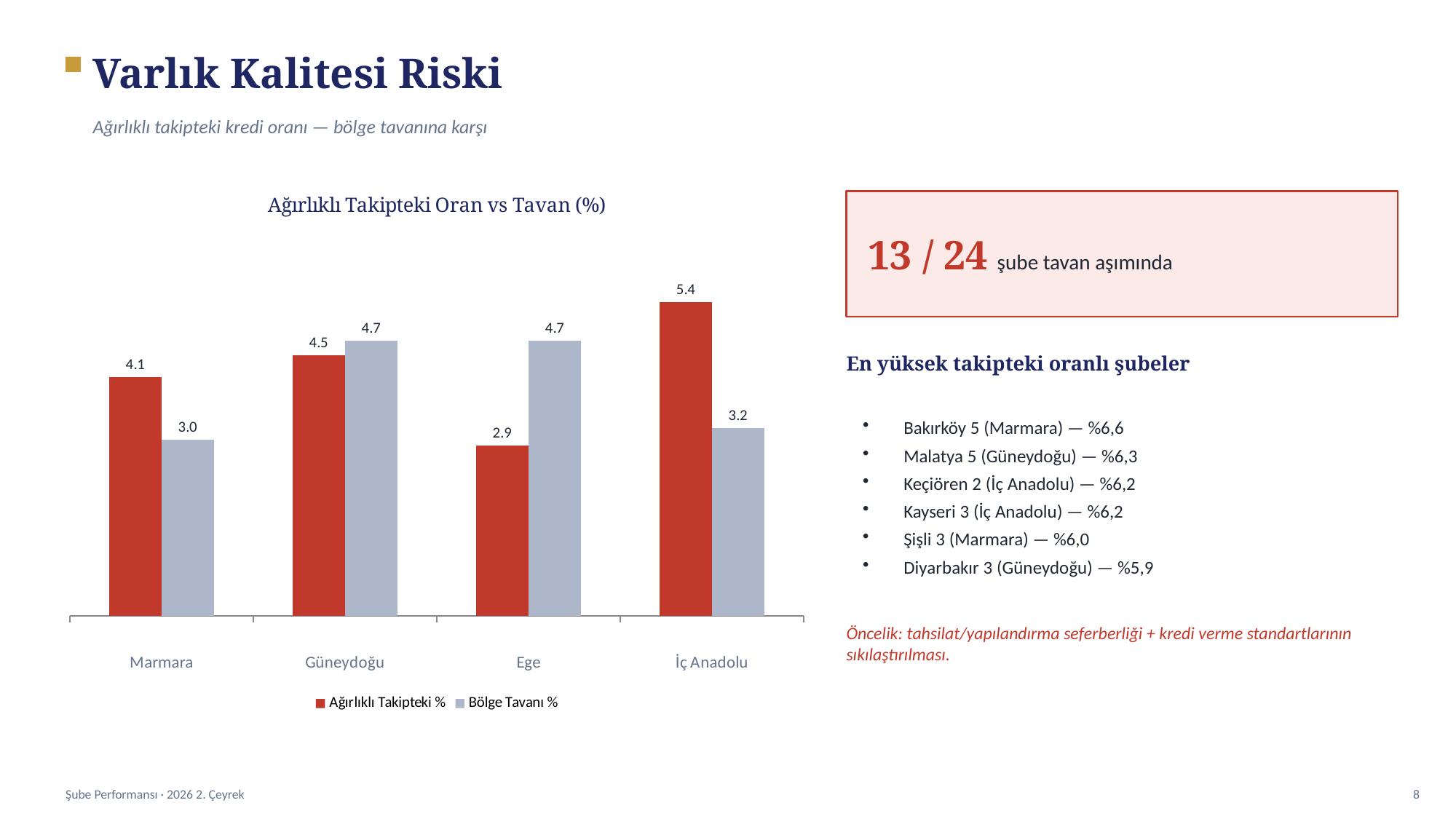
How many regions are shown on the x axis of the chart? 4 What is the Ağırlıklı Takipteki % value for Marmara? 4.1 Which region has the lowest Ağırlıklı Takipteki % value? Ege What is the Bölge Tavanı % value for Ege? 4.7 What is the title of the chart? Ağırlıklı Takipteki Oran vs Tavan (%) What is the Ağırlıklı Takipteki % value for İç Anadolu? 5.4 For Marmara, which is larger: Ağırlıklı Takipteki % or Bölge Tavanı %? Ağırlıklı Takipteki % What is the difference between the Ağırlıklı Takipteki % and Bölge Tavanı % values for İç Anadolu? 2.2 Which region has the highest Ağırlıklı Takipteki % value? İç Anadolu What kind of chart is shown on the slide? Bar chart How many series does the chart legend list? 2 For Ege, which is larger: Ağırlıklı Takipteki % or Bölge Tavanı %? Bölge Tavanı %